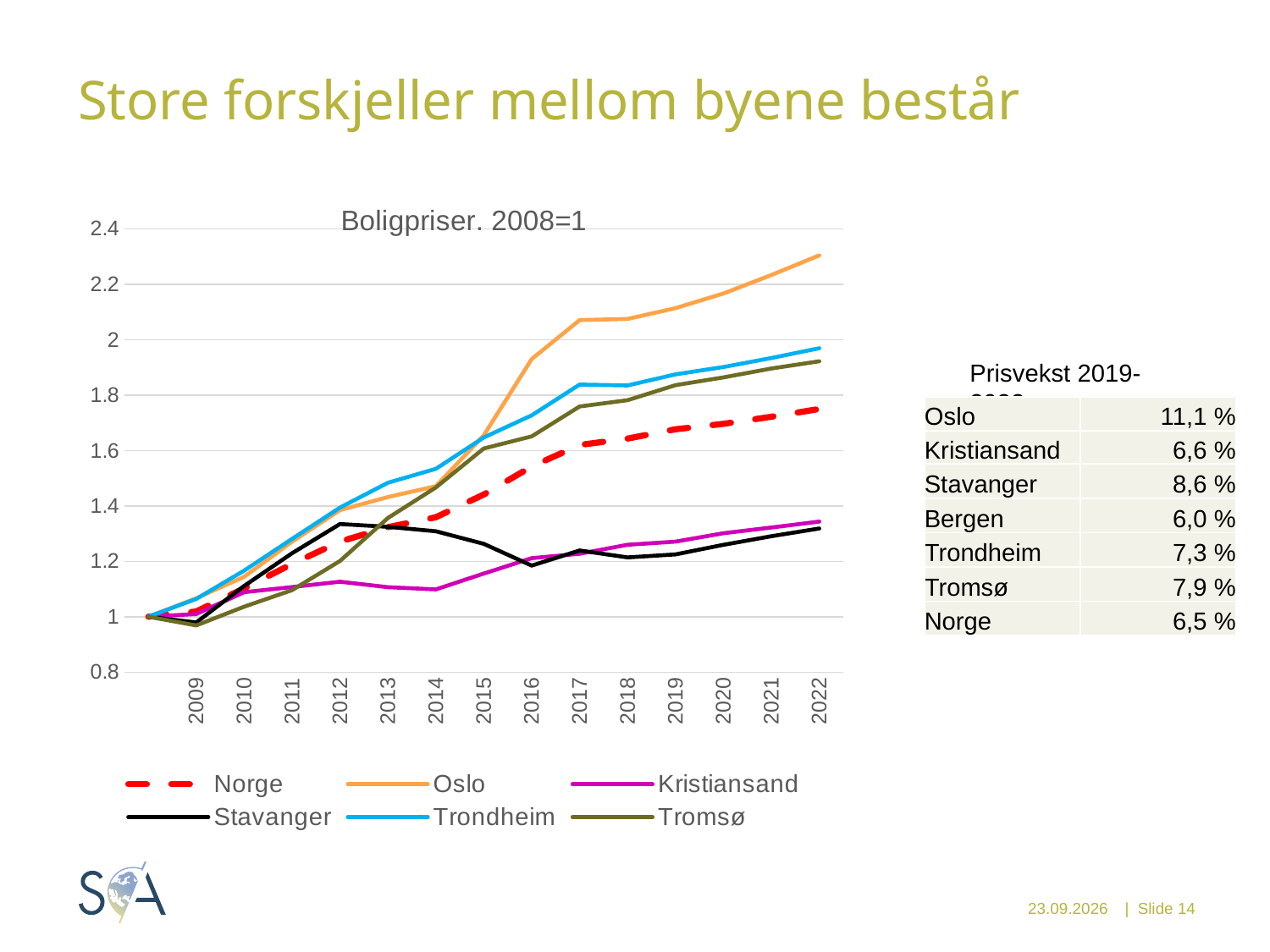
What is the title of the chart? Boligpriser. 2008=1 In 2012, which is larger: the value for Stavanger or the value for Kristiansand? Stavanger Which series has the lowest value in 2014? Kristiansand Does the Oslo series rise or fall from 2009 to 2022? rise Is the value for Norge in 2022 greater or less than 1.8? less Which series is drawn with a dashed line? Norge How many series does the chart legend list? 6 How many years are shown on the x axis of the chart? 14 Is the value for Stavanger in 2012 greater or less than 1.2? greater Is the value for Oslo in 2022 greater or less than 2.2? greater What kind of chart is shown on the slide? line chart Which series has the highest value in 2022? Oslo